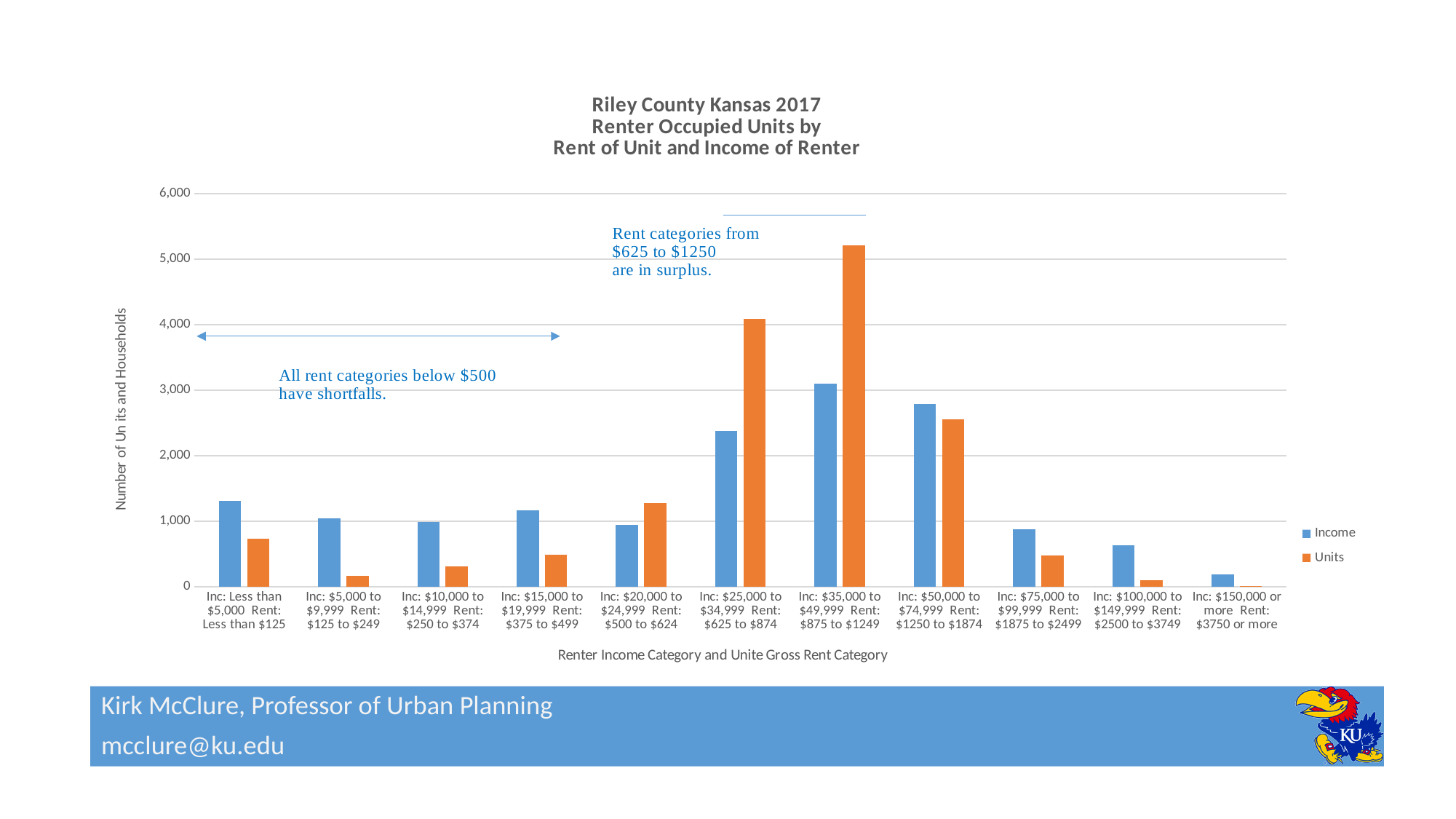
How many series does the legend list? 2 What is the title of the chart? Riley County Kansas 2017 Renter Occupied Units by Rent of Unit and Income of Renter Which category has the lowest Units value? Inc: $150,000 or more Rent: $3750 or more For Inc: $25,000 to $34,999 Rent: $625 to $874, which is larger, Income or Units? Units Which category has the highest Units value? Inc: $35,000 to $49,999 Rent: $875 to $1249 How many income/rent categories are shown on the x axis? 11 What type of chart is shown on the slide? Bar chart Is the Income value for Inc: $50,000 to $74,999 Rent: $1250 to $1874 greater or less than 2,000? greater Which category has the highest Income value? Inc: $35,000 to $49,999 Rent: $875 to $1249 Is the Units value for Inc: $5,000 to $9,999 Rent: $125 to $249 greater or less than 1,000? less Is the Units value for Inc: $35,000 to $49,999 Rent: $875 to $1249 greater or less than 5,000? greater